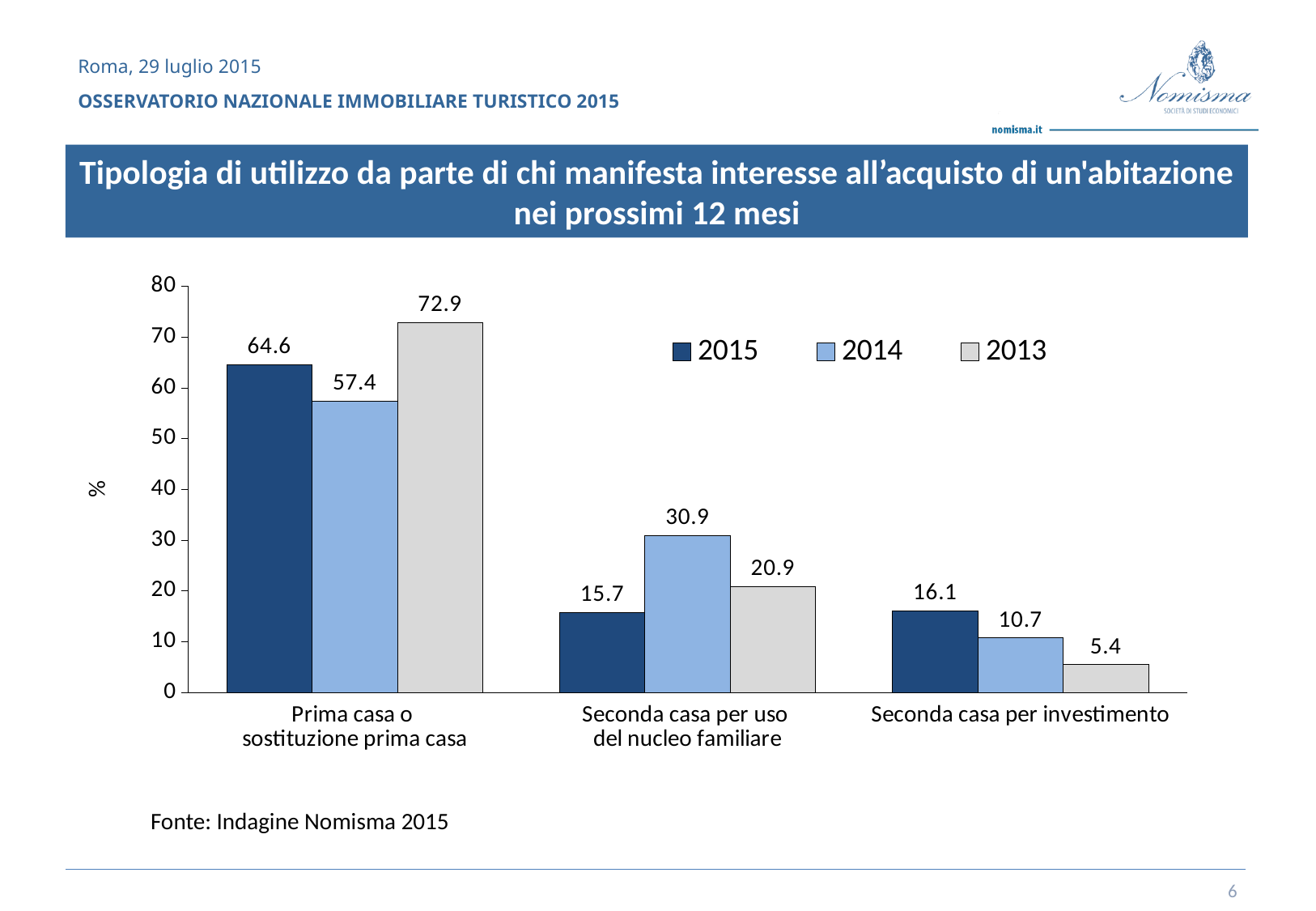
What is the difference between the 2014 and 2015 values for "Seconda casa per uso del nucleo familiare"? 15.2 Which category has the lowest 2015 value? Seconda casa per uso del nucleo familiare What is the 2014 value for "Seconda casa per uso del nucleo familiare"? 30.9 Which is larger for "Seconda casa per investimento": the 2015 value or the 2014 value? 2015 How many categories are shown on the x axis? 3 What label is shown on the y axis? % What kind of chart is shown on the slide? Bar chart What is the 2013 value for "Seconda casa per investimento"? 5.4 What is the 2015 value for "Prima casa o sostituzione prima casa"? 64.6 How many series does the legend list? 3 Which category has the highest 2013 value? Prima casa o sostituzione prima casa What is the difference between the 2013 and 2015 values for "Prima casa o sostituzione prima casa"? 8.3